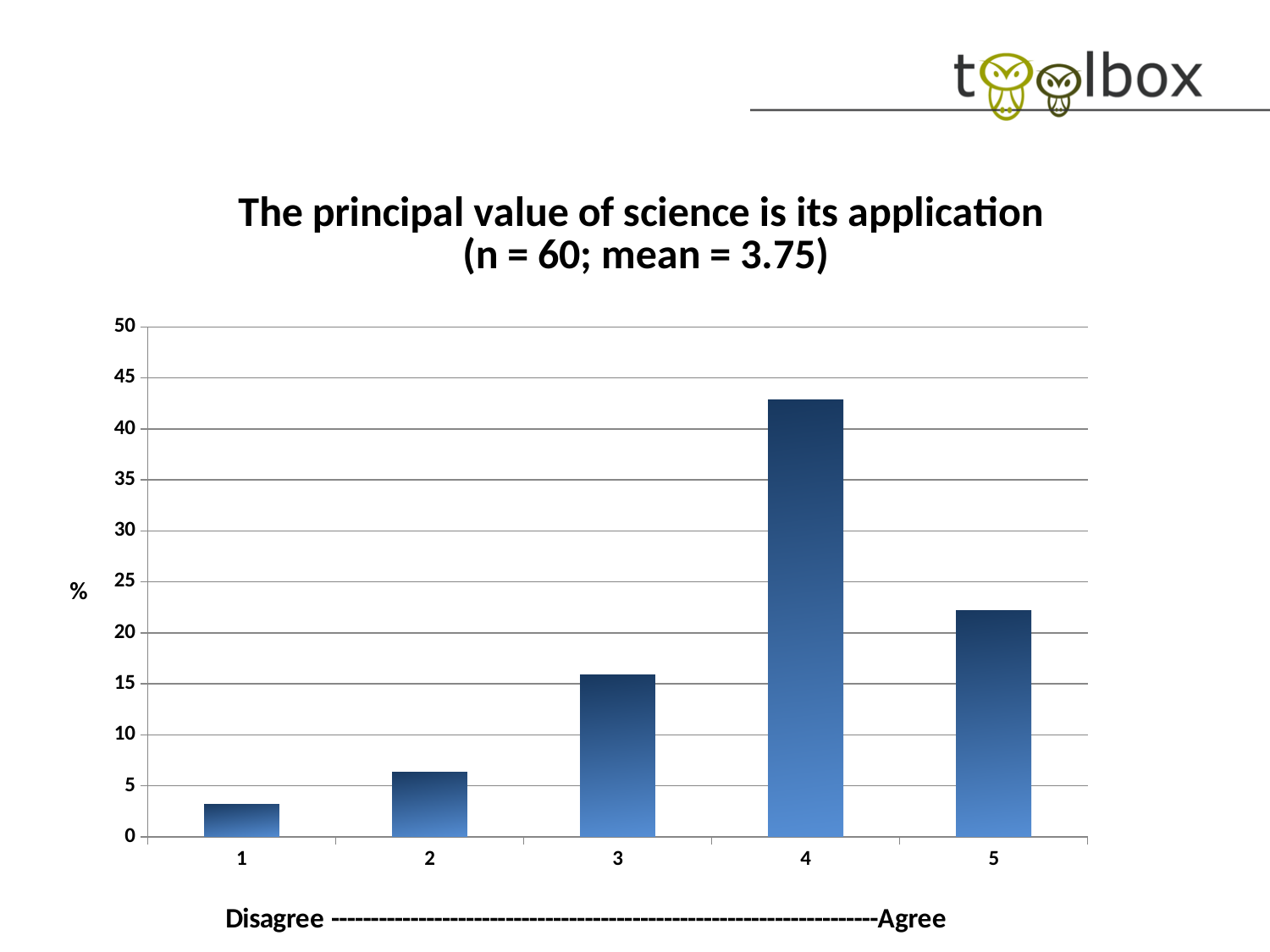
Which is larger, the value for category 5 or the value for category 3? 5 What is the title of the chart? The principal value of science is its application (n = 60; mean = 3.75) Is the value for category 5 greater or less than 25? less What type of chart is shown on the slide? bar chart Which category has the highest value? 4 Is the value for category 1 greater or less than 5? less Which category has the lowest value? 1 Is the value for category 4 greater or less than 40? greater What is the label on the y axis? % How many categories are shown on the x axis? 5